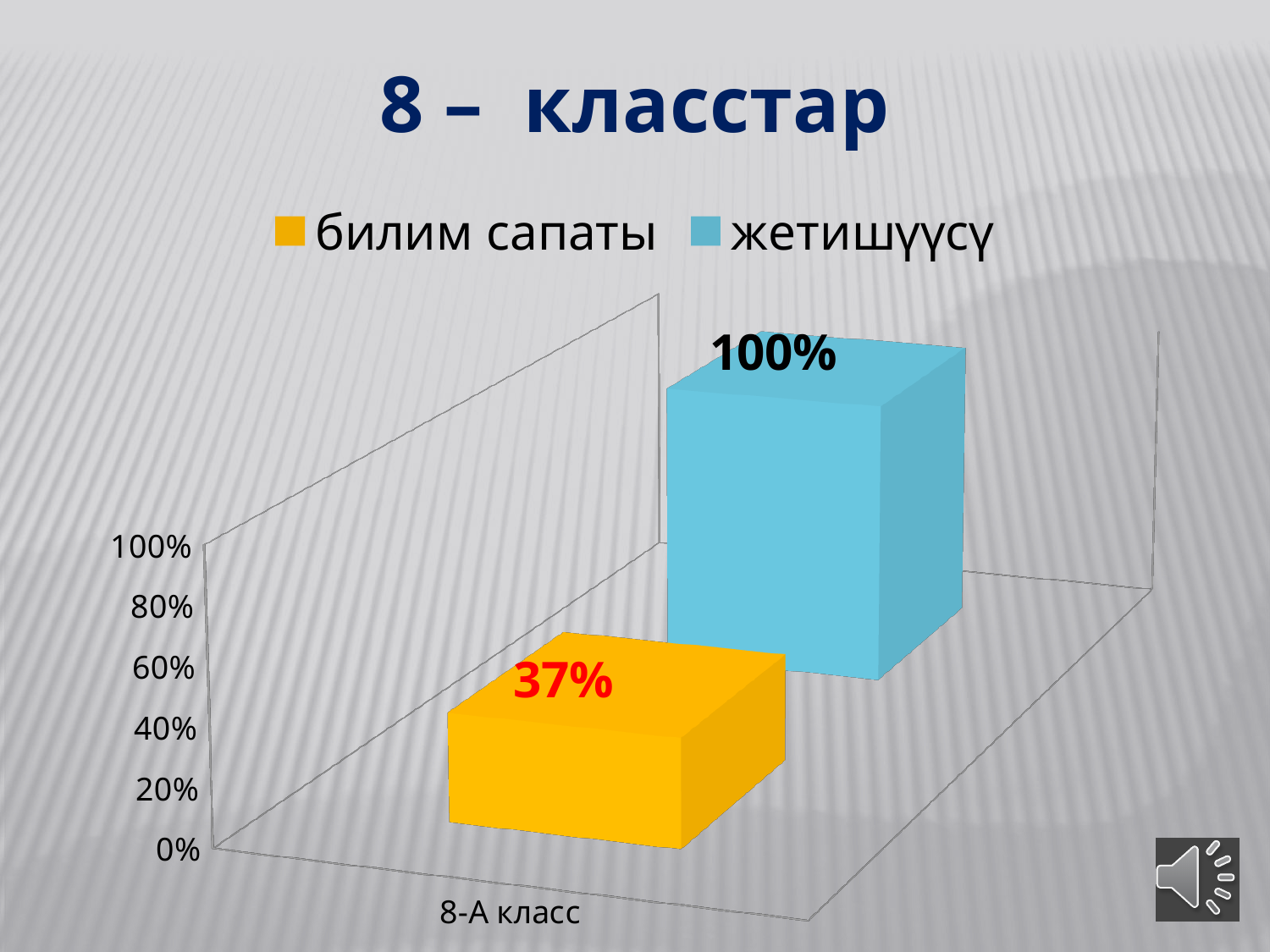
What is the title of the slide? 8 – класстар How many series does the legend list? 2 What is the value for билим сапаты for 8-А класс? 37% How many categories are shown on the x axis? 1 What kind of chart is shown on the slide? bar chart Is the value for жетишүүсү greater or less than 80%? greater Which colour represents билим сапаты in the legend? yellow What is the value for жетишүүсү for 8-А класс? 100% Which series has the higher value for 8-А класс, билим сапаты or жетишүүсү? жетишүүсү What is the label of the category on the x axis? 8-А класс What is the difference between the жетишүүсү and билим сапаты values for 8-А класс? 63% Is the value for билим сапаты greater or less than 40%? less